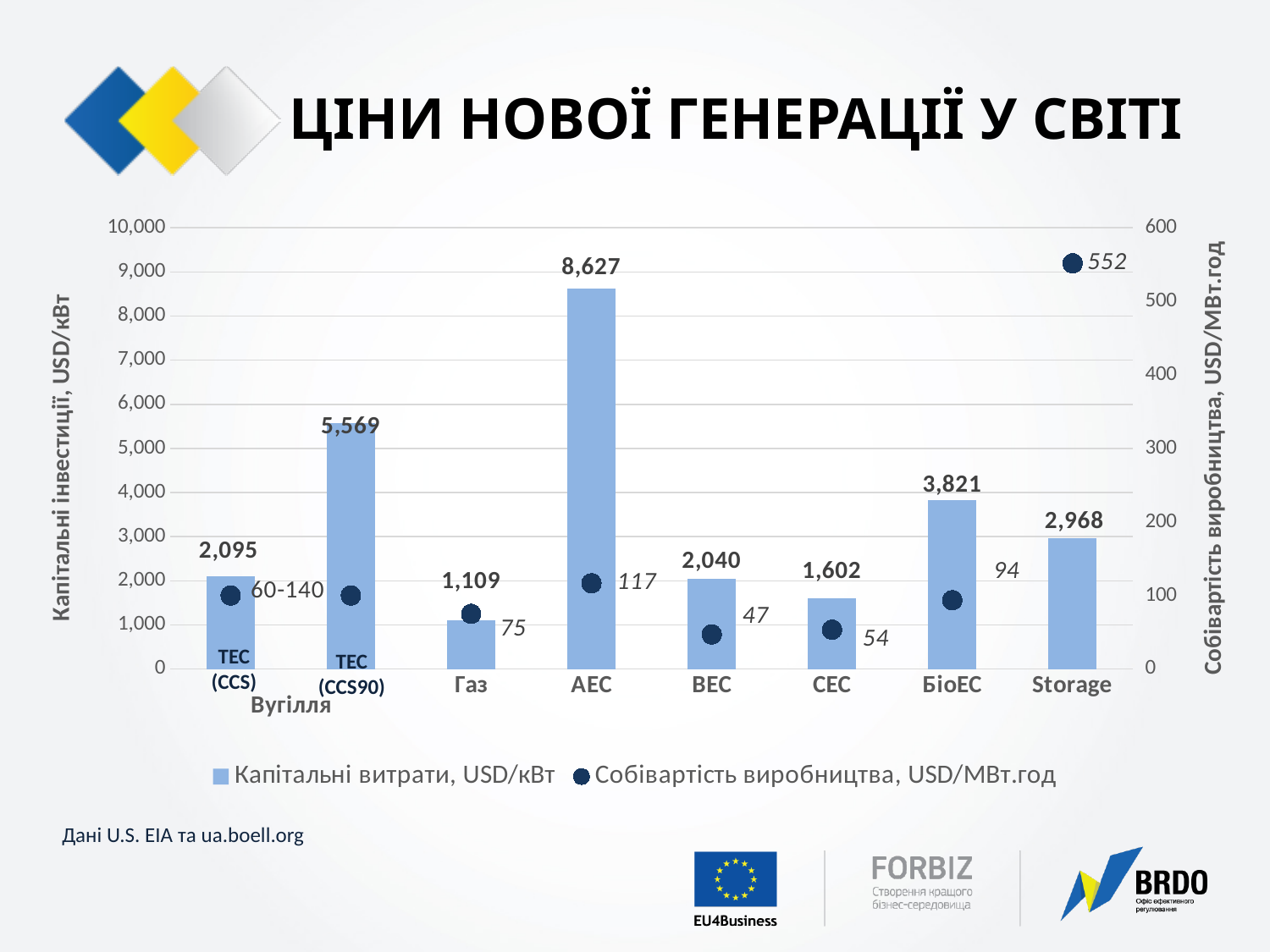
Which has a higher production cost, СЕС or Газ? Газ Which category has the highest capital cost bar? АЕС How many categories are shown on the x axis? 8 What is the title of the chart slide? ЦІНИ НОВОЇ ГЕНЕРАЦІЇ У СВІТІ What is the difference between the capital cost of АЕС and ТЕС (CCS90)? 3,058 How many series does the legend list? 2 What is the production cost value shown for ВЕС? 47 What is the capital cost value for ТЕС (CCS90)? 5,569 Which category has the lowest capital cost bar? Газ What is the capital cost (Капітальні витрати) value for АЕС? 8,627 What is the production cost (Собівартість виробництва) value shown for Storage? 552 Which has a larger capital cost, БіоЕС or Storage? БіоЕС